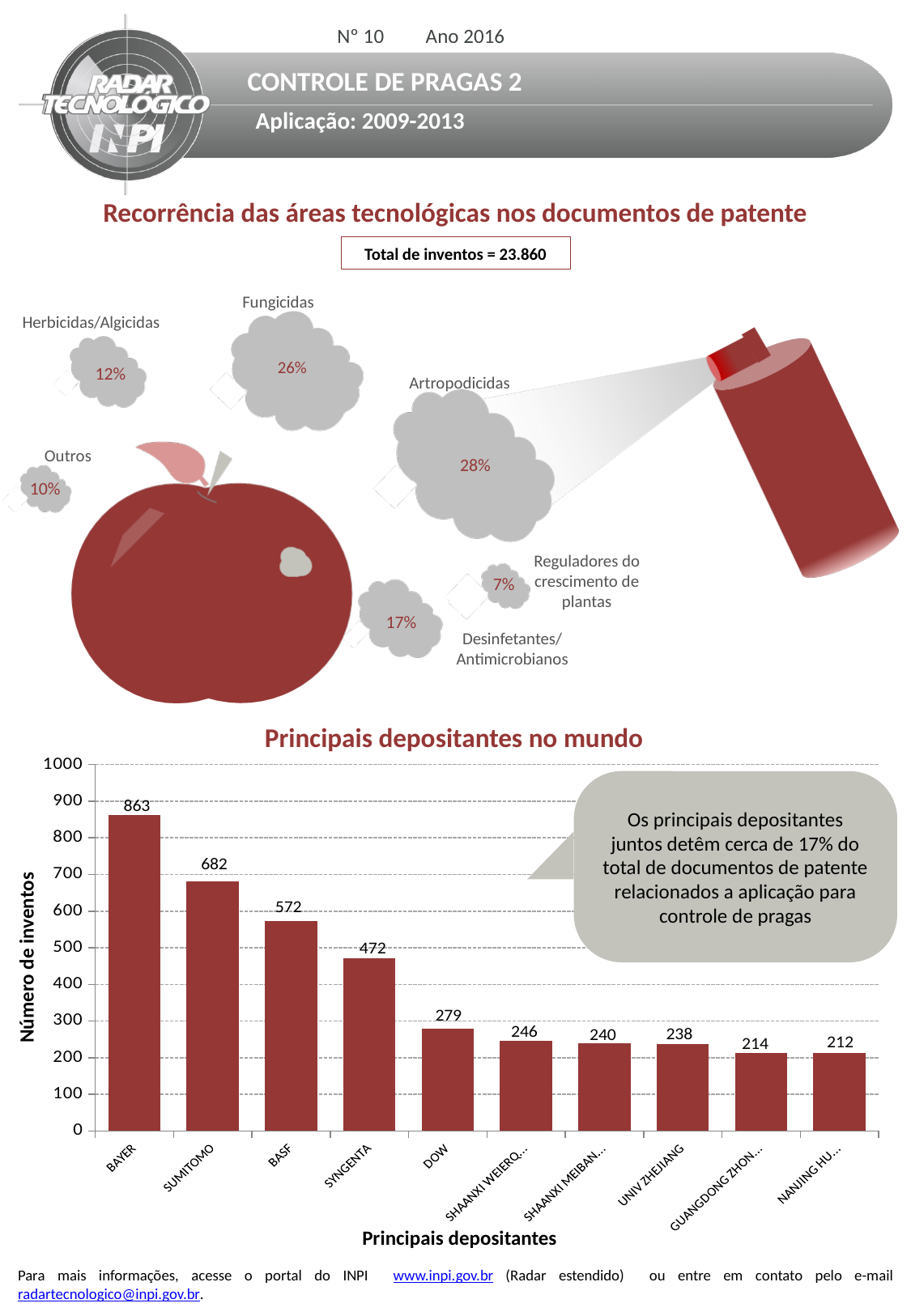
In the chart 'Principais depositantes no mundo', which is larger, the value for BASF or the value for SYNGENTA? BASF In the chart 'Principais depositantes no mundo', what is the value for DOW? 279 What kind of chart is 'Principais depositantes no mundo'? bar chart In the chart 'Principais depositantes no mundo', what is the value for SYNGENTA? 472 In the chart 'Principais depositantes no mundo', which depositor has the highest number of inventions? BAYER In the infographic 'Recorrência das áreas tecnológicas nos documentos de patente', what is the total number of inventions stated? 23.860 In the chart 'Principais depositantes no mundo', how many depositors are shown on the x axis? 10 In the infographic 'Recorrência das áreas tecnológicas nos documentos de patente', what percentage is shown for Artropodicidas? 28% In the chart 'Principais depositantes no mundo', what is the value for BAYER? 863 In the chart 'Principais depositantes no mundo', what is the difference between the values for BAYER and SUMITOMO? 181 In the chart 'Principais depositantes no mundo', do the values rise or fall from left to right along the x axis? fall In the chart 'Principais depositantes no mundo', what is the label of the y axis? Número de inventos